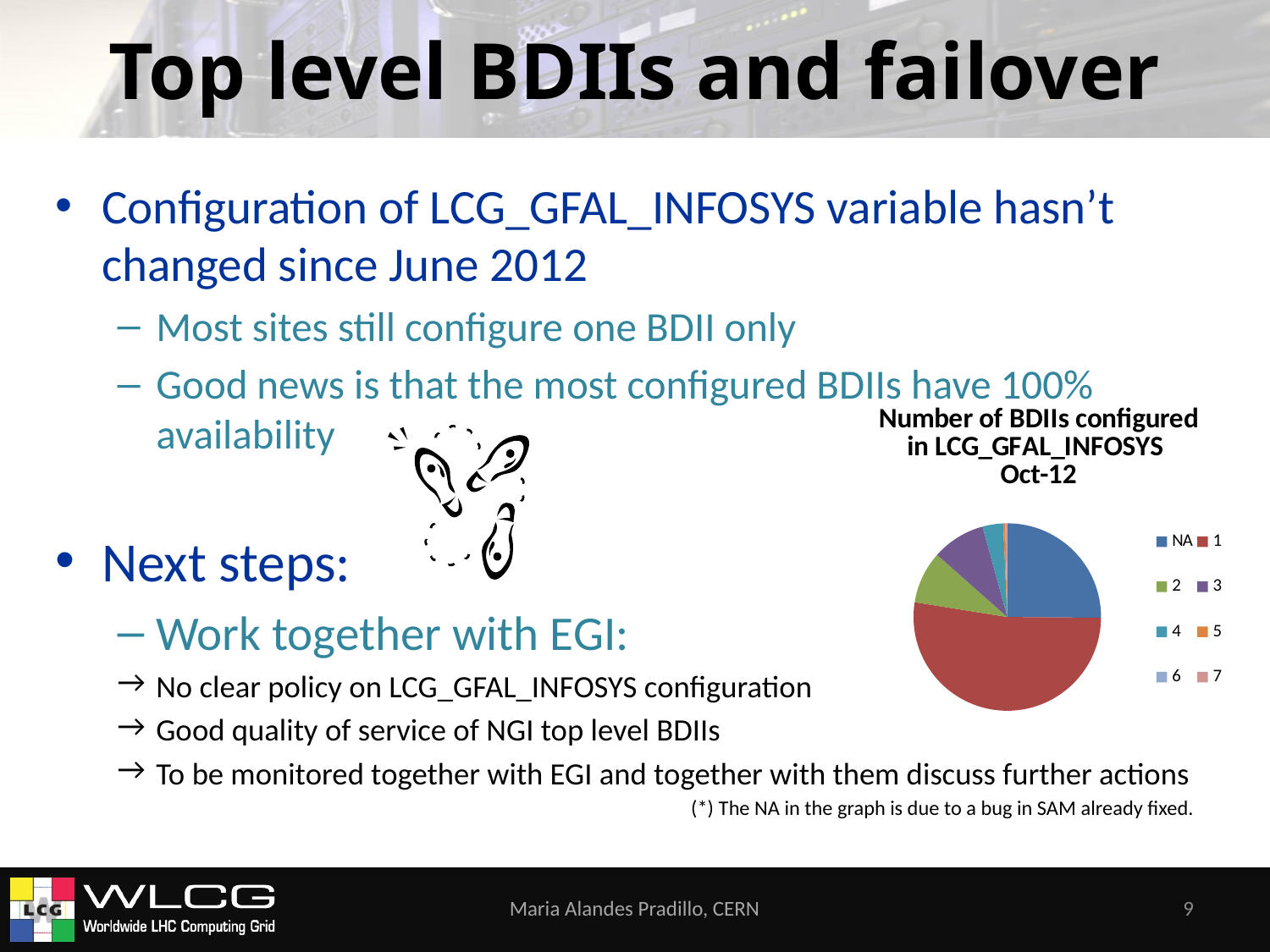
Which category has the second-largest slice of the pie? NA Which slice is larger, the one for 1 or the one for NA? 1 Which slice is larger, the one for NA or the one for 2? NA How many entries does the chart's legend list? 8 What is the title of the chart on the slide? Number of BDIIs configured in LCG_GFAL_INFOSYS Oct-12 What kind of chart is shown on the slide? pie chart What colour is the slice for category 1? red Which category has the largest slice of the pie? 1